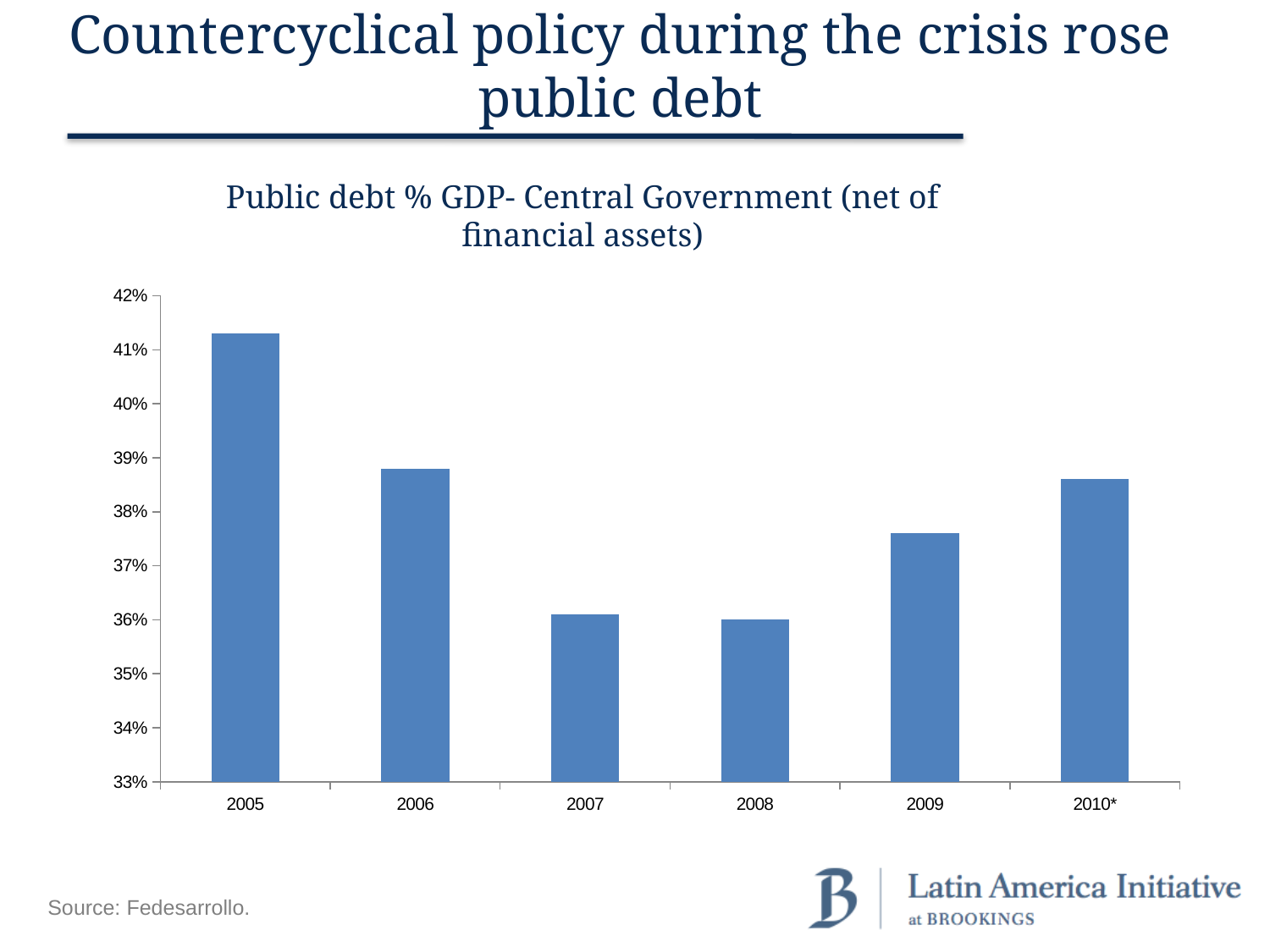
Is the value for 2010* greater or less than 38%? greater Is the value for 2009 greater or less than 37%? greater Which is larger, the value for 2005 or the value for 2006? 2005 What is the title of the chart? Public debt % GDP- Central Government (net of financial assets) Is the value for 2005 greater or less than 40%? greater How many years are plotted on the chart? 6 Which is larger, the value for 2009 or the value for 2010*? 2010* What kind of chart is shown on the slide? Bar chart Which year has the highest public debt as % of GDP? 2005 Do the values rise or fall from 2005 to 2008? fall